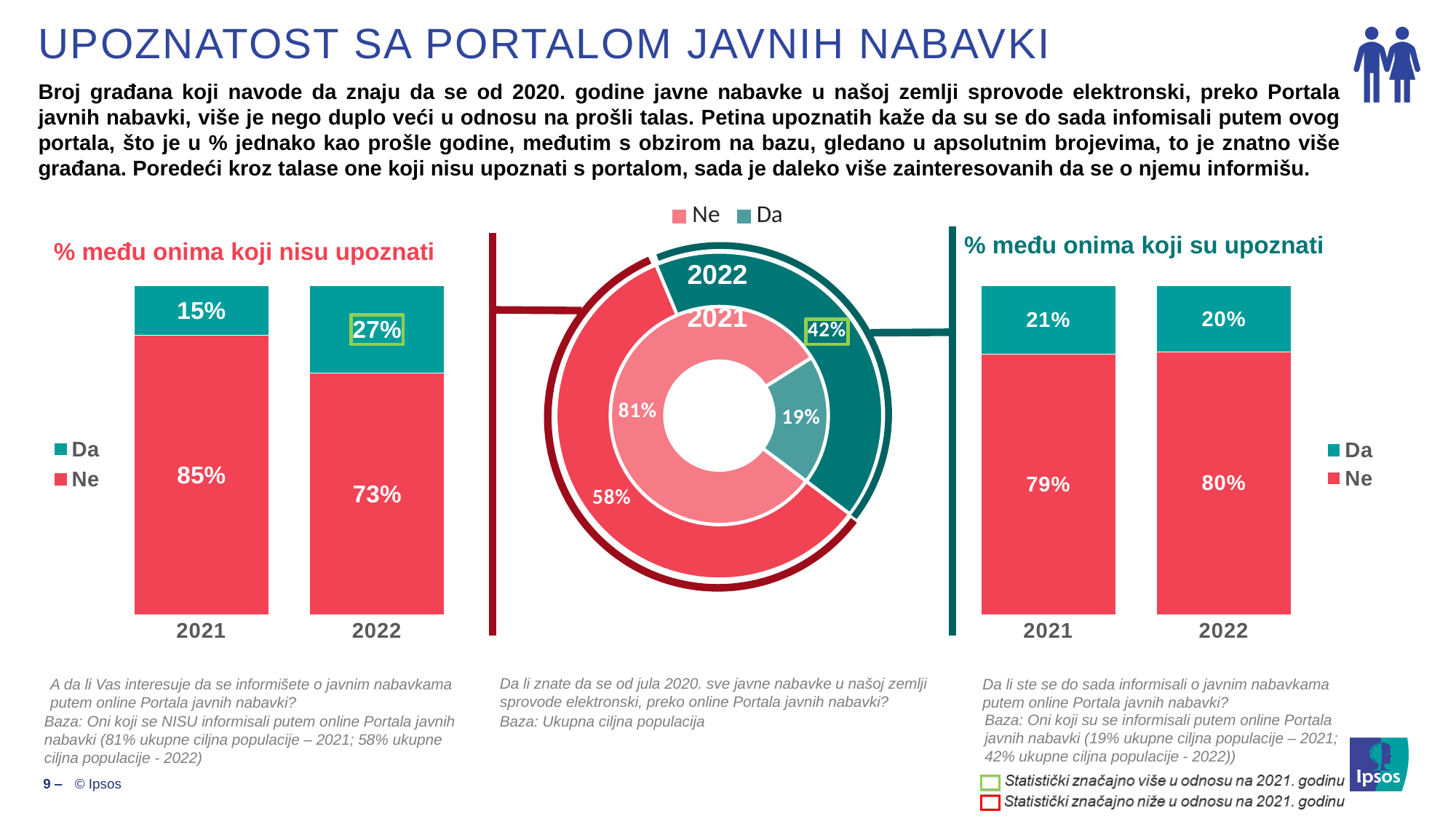
In the centre donut chart, what is the value for "Ne" in 2021? 81% In the centre donut chart, what is the difference between "Ne" in 2021 and "Ne" in 2022? 23 percentage points In the right chart titled "% među onima koji su upoznati", what is the value for "Ne" in 2022? 80% In the left chart titled "% među onima koji nisu upoznati", what is the value for "Ne" in 2021? 85% How many series does the legend of the right chart titled "% među onima koji su upoznati" list? 2 In the left chart titled "% među onima koji nisu upoznati", what is the total of the stacked bar for 2022? 100% In the right chart titled "% među onima koji su upoznati", what is the value for "Da" in 2021? 21% In the centre donut chart, which is larger: "Da" in 2021 or "Da" in 2022? Da in 2022 In the centre donut chart, what share of the 2022 ring is "Da"? 42% In the left chart titled "% među onima koji nisu upoznati", what is the value for "Da" in 2022? 27% What kind of chart is the centre chart on the slide? Donut chart In the left chart titled "% među onima koji nisu upoznati", by how many percentage points did "Da" change from 2021 to 2022? 12 percentage points